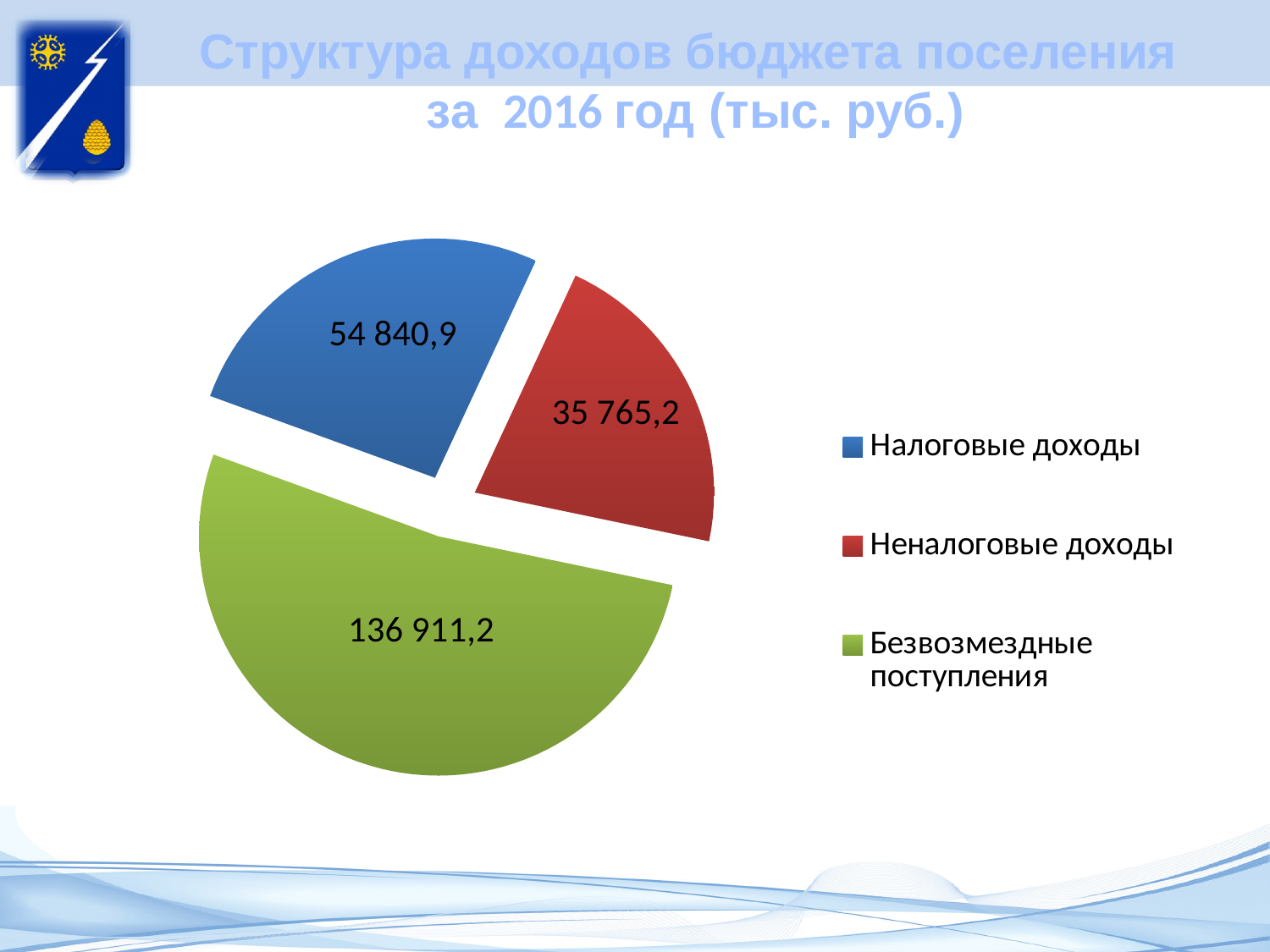
What is the difference between Налоговые доходы and Неналоговые доходы? 19 075,7 What is the value for Налоговые доходы? 54 840,9 Which is larger, Налоговые доходы or Неналоговые доходы? Налоговые доходы What is the value for Неналоговые доходы? 35 765,2 How many slices does the pie chart have? 3 What is the difference between Безвозмездные поступления and Налоговые доходы? 82 070,3 What type of chart is shown on the slide? Pie chart What colour is the slice for Безвозмездные поступления? Green Which category has the smallest value? Неналоговые доходы Which category has the largest value? Безвозмездные поступления What is the total of all slices in the pie chart? 227 517,3 What is the value for Безвозмездные поступления? 136 911,2